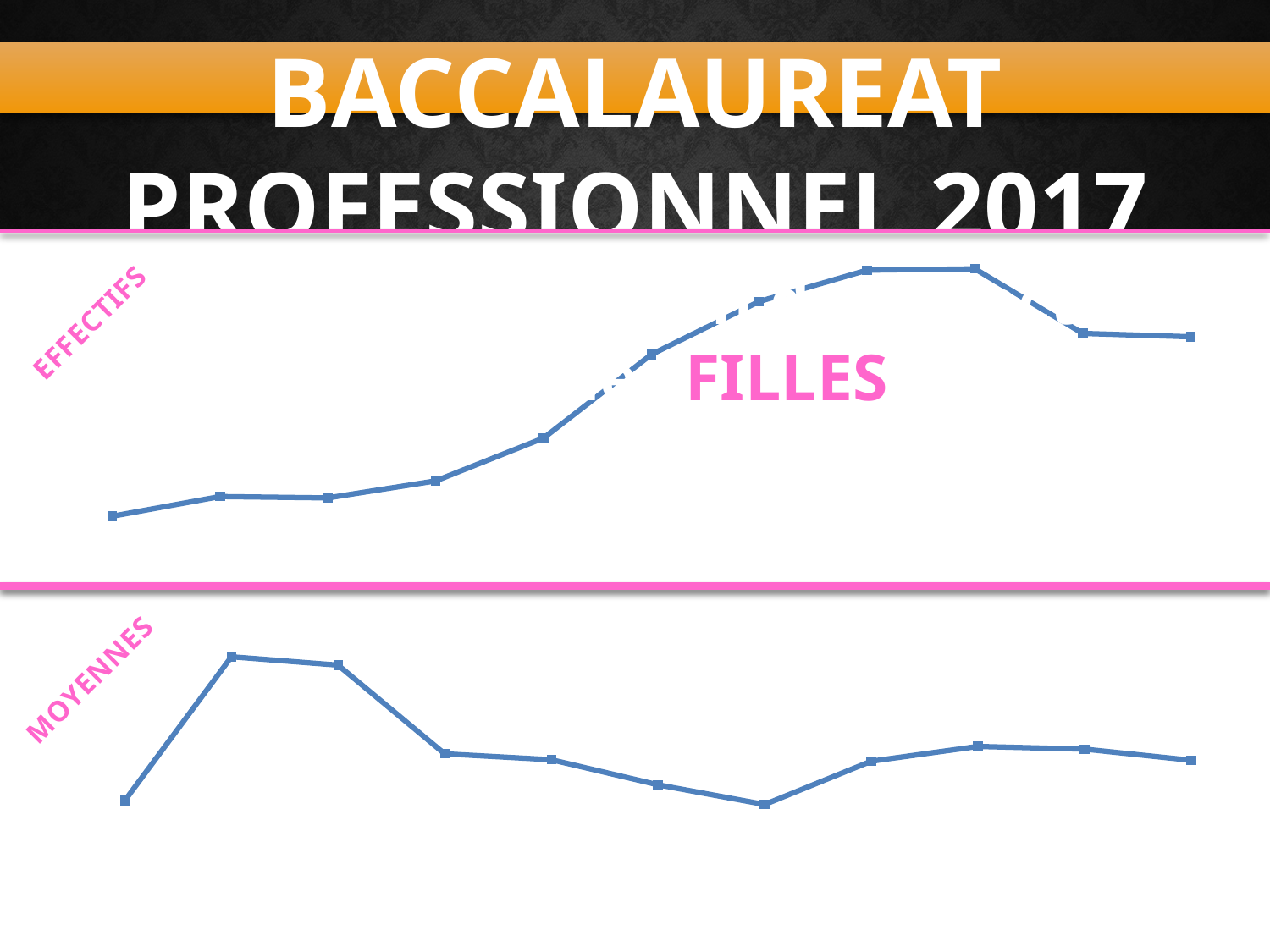
What is the rotated pink label next to the bottom chart? MOYENNES In the top chart labelled EFFECTIFS, does the line rise or fall over its last three points? fall What kind of chart is the bottom chart labelled MOYENNES? line chart What kind of chart is the top chart labelled EFFECTIFS? line chart In the top chart labelled EFFECTIFS, does the line generally rise or fall from the first point to the eighth point? rise In the bottom chart labelled MOYENNES, does the line rise or fall between the third and fourth points? fall In the bottom chart labelled MOYENNES, which point is the highest: the second or the last? the second What pink label is written over the top chart? FILLES How many data points are plotted on the bottom chart labelled MOYENNES? 11 In the top chart labelled EFFECTIFS, which point is the lowest: the first or the last? the first In the top chart labelled EFFECTIFS, is the last point higher or lower than the first point? higher